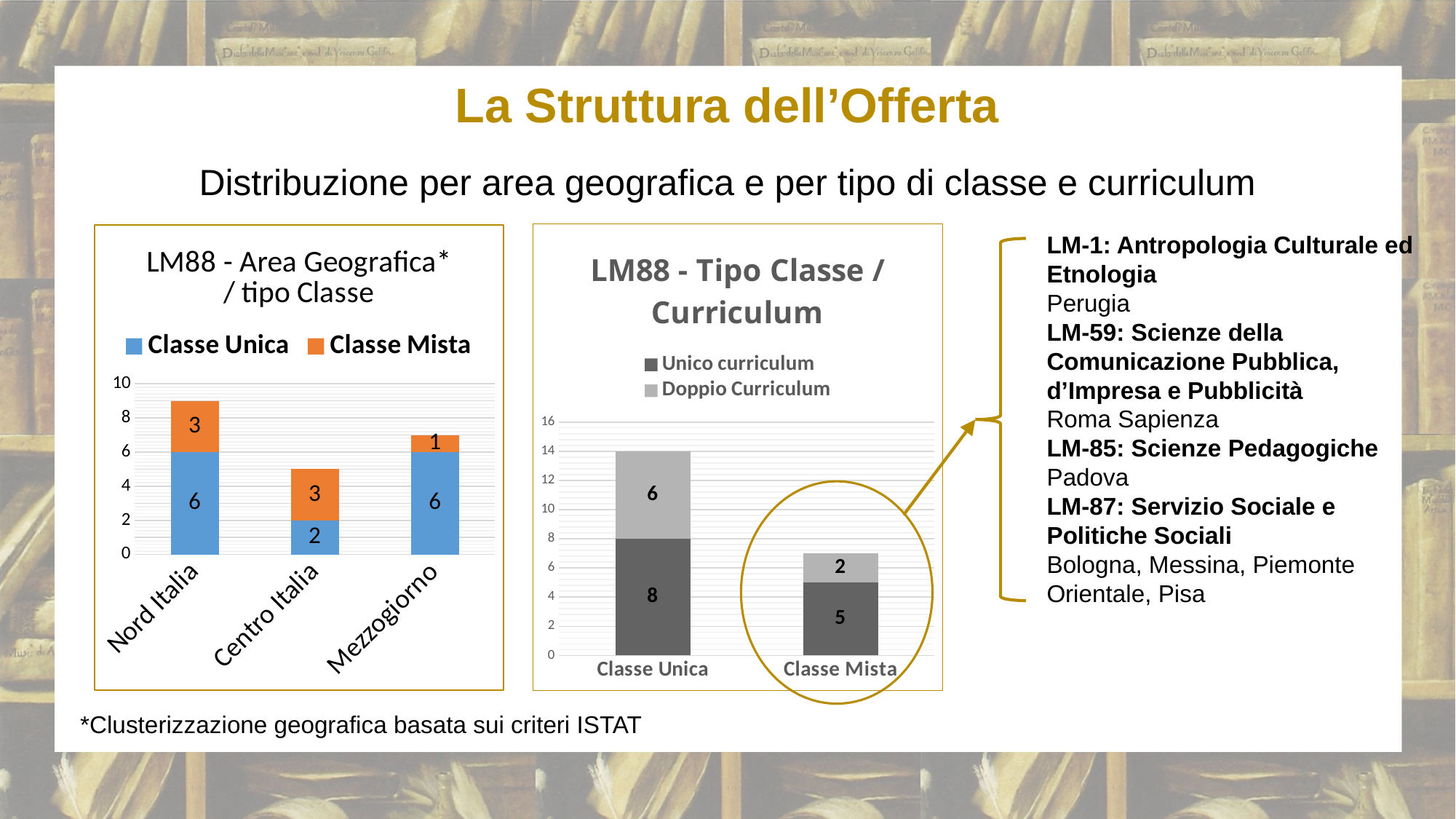
In the chart titled "LM88 - Tipo Classe / Curriculum", what is the Doppio Curriculum value for Classe Mista? 2 In the chart titled "LM88 - Tipo Classe / Curriculum", what is the Unico curriculum value for Classe Unica? 8 In the chart titled "LM88 - Area Geografica* / tipo Classe", what is the Classe Mista value for Mezzogiorno? 1 In the chart titled "LM88 - Area Geografica* / tipo Classe", what is the difference between the Classe Unica and Classe Mista values for Centro Italia? 1 In the chart titled "LM88 - Area Geografica* / tipo Classe", how many geographic areas are shown on the x axis? 3 In the chart titled "LM88 - Tipo Classe / Curriculum", what is the total of the stacked bar for Classe Unica? 14 In the chart titled "LM88 - Area Geografica* / tipo Classe", which geographic area has the lowest Classe Unica value? Centro Italia What kind of chart is the one titled "LM88 - Tipo Classe / Curriculum"? Stacked bar chart In the chart titled "LM88 - Tipo Classe / Curriculum", which is larger: the Unico curriculum value for Classe Unica or for Classe Mista? Classe Unica In the chart titled "LM88 - Area Geografica* / tipo Classe", what is the total of the stacked bar for Nord Italia? 9 In the chart titled "LM88 - Tipo Classe / Curriculum", how many series does the legend list? 2 In the chart titled "LM88 - Area Geografica* / tipo Classe", what is the Classe Unica value for Nord Italia? 6